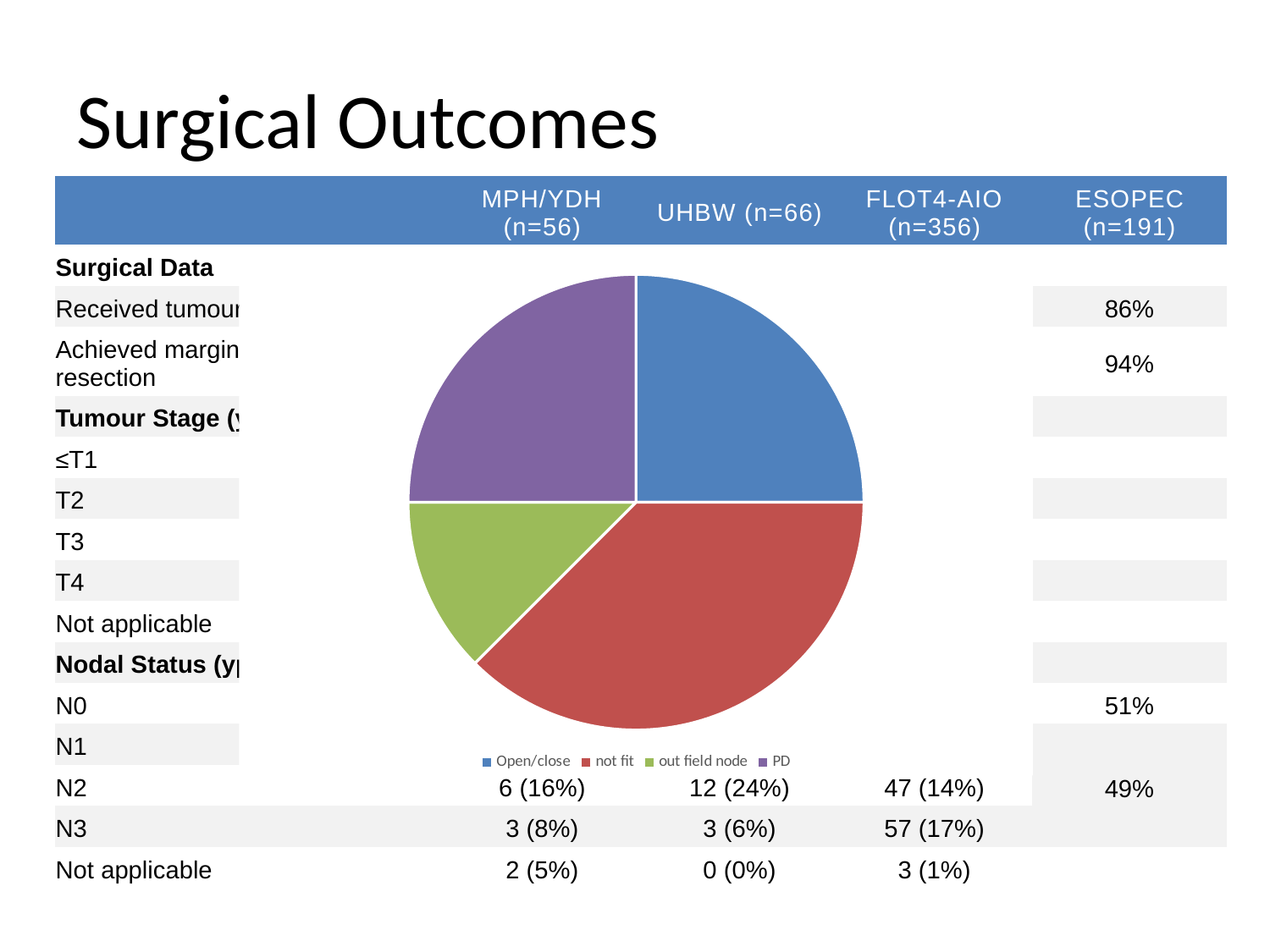
How many slices does the pie chart have? 4 What kind of chart is shown on the slide? pie chart Which legend entry is shown in green in the pie chart? out field node Which slice is larger in the pie chart, 'not fit' or 'out field node'? not fit Which slice is larger in the pie chart, 'not fit' or 'PD'? not fit How many entries does the pie chart's legend list? 4 Which slice is larger in the pie chart, 'Open/close' or 'out field node'? Open/close What colour is the 'not fit' slice in the pie chart? red Which category has the smallest slice of the pie chart? out field node Which category has the largest slice of the pie chart? not fit